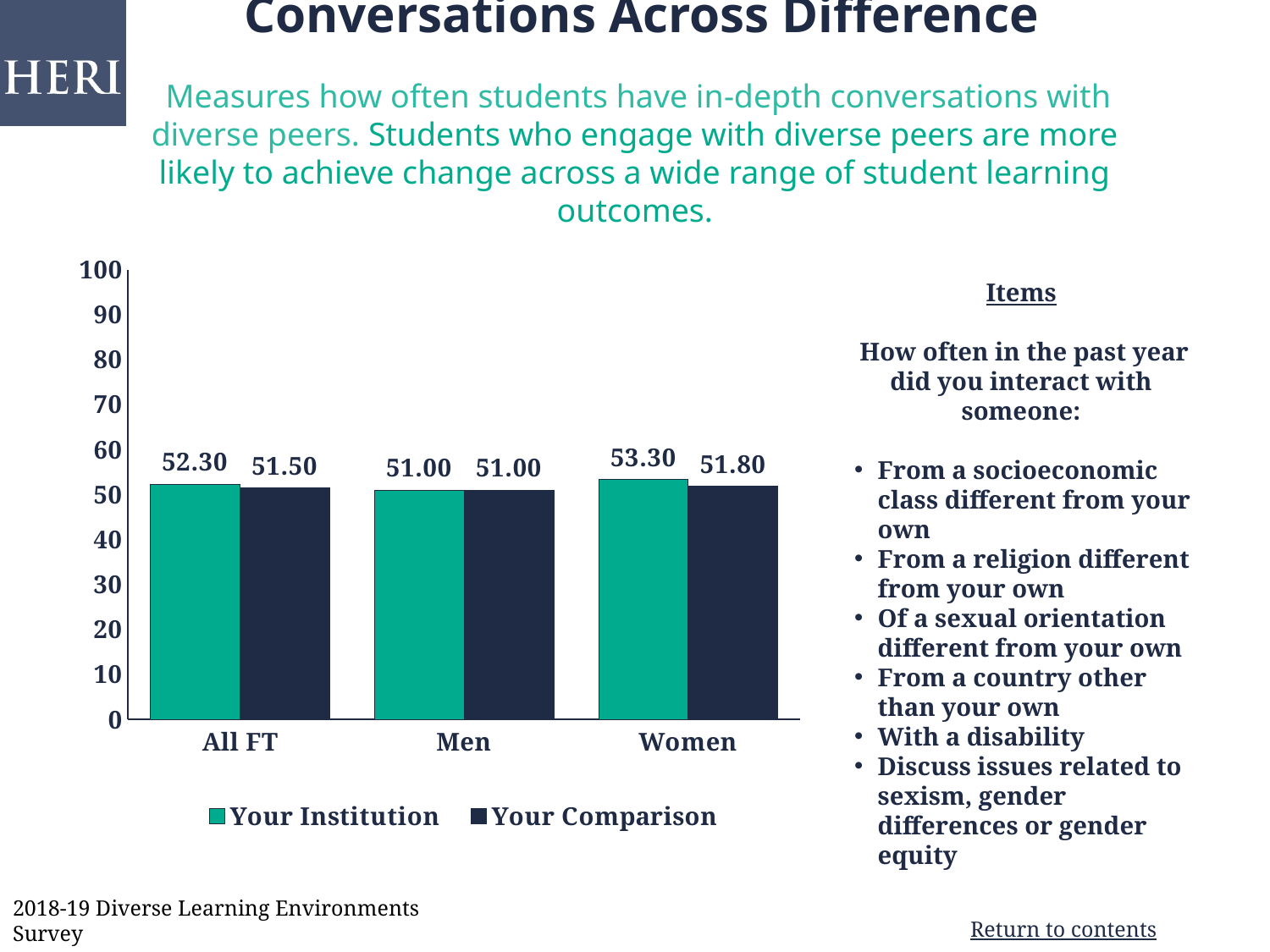
What is the difference between Your Institution and Your Comparison for All FT? 0.80 What is the value for Your Institution for Men? 51.00 What is the value for Your Comparison for All FT? 51.50 Is the Your Institution value for All FT greater or less than 50? greater Which category has the highest Your Institution value? Women How many series does the legend list? 2 What kind of chart is shown on the slide? bar chart Which category has the lowest Your Comparison value? Men What are the two series named in the legend? Your Institution and Your Comparison How many categories are shown on the x axis? 3 What is the value for Your Institution for Women? 53.30 What is the difference between Your Institution and Your Comparison for Women? 1.50